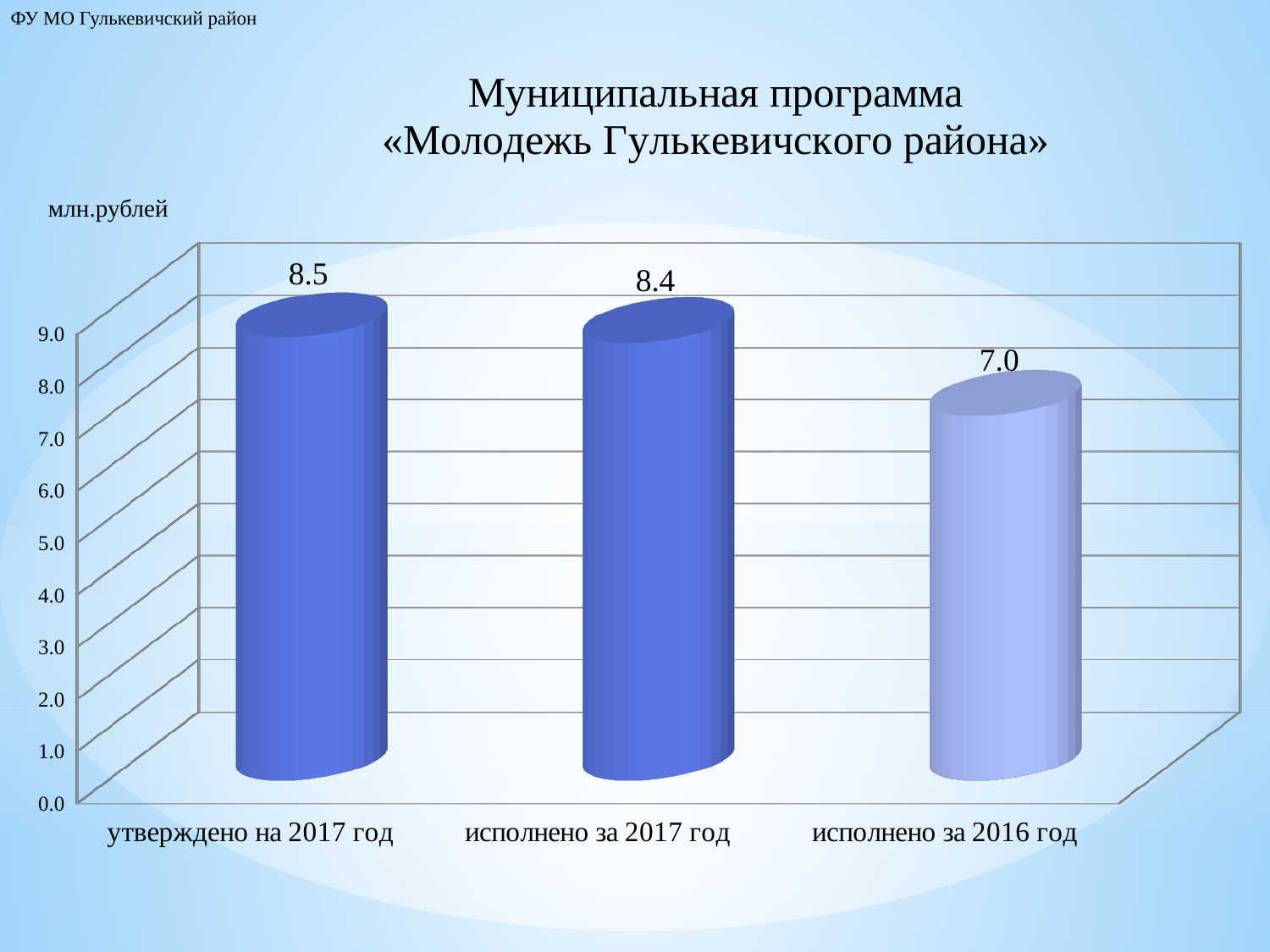
What is the value for «исполнено за 2017 год»? 8.4 What unit is indicated for the values in the chart? млн.рублей What is the difference between the values for «утверждено на 2017 год» and «исполнено за 2017 год»? 0.1 Is the value for «исполнено за 2016 год» greater or less than 8.0? less What kind of chart is shown on the slide? bar chart Which is larger: the value for «исполнено за 2017 год» or «исполнено за 2016 год»? исполнено за 2017 год What is the difference between the values for «исполнено за 2017 год» and «исполнено за 2016 год»? 1.4 What is the value for «исполнено за 2016 год»? 7.0 Which category has the highest value? утверждено на 2017 год Which category has the lowest value? исполнено за 2016 год How many categories are shown in the chart? 3 What is the value for «утверждено на 2017 год»? 8.5